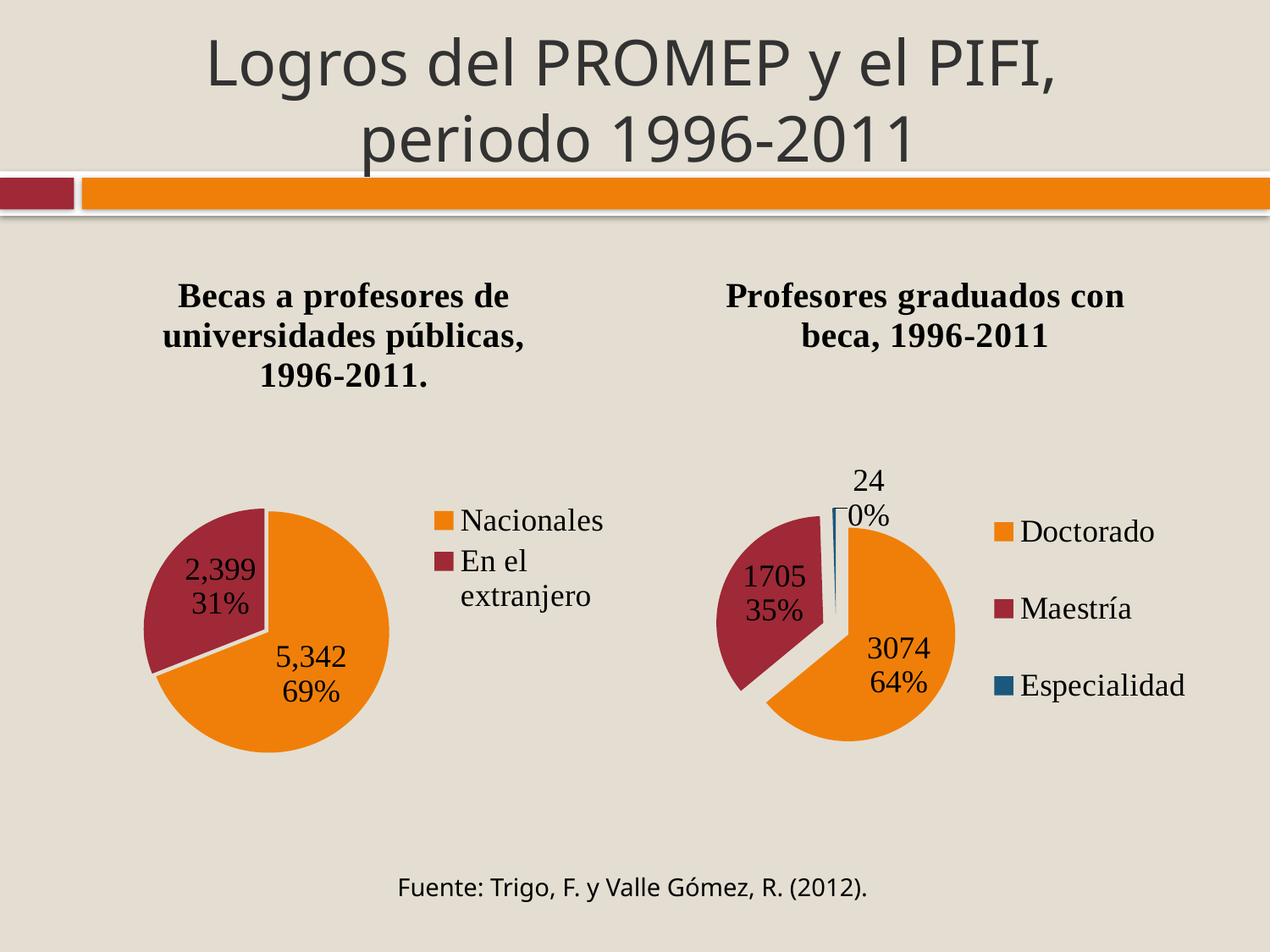
In the 'Becas a profesores de universidades públicas, 1996-2011' chart, what is the difference between Nacionales and En el extranjero? 2,943 In the 'Profesores graduados con beca, 1996-2011' chart, what share of the pie is Doctorado? 64% In the 'Becas a profesores de universidades públicas, 1996-2011' chart, what is the value for Nacionales? 5,342 In the 'Profesores graduados con beca, 1996-2011' chart, which category is the smallest? Especialidad In the 'Profesores graduados con beca, 1996-2011' chart, what is the value for Maestría? 1705 In the 'Profesores graduados con beca, 1996-2011' chart, which is larger, Doctorado or Maestría? Doctorado In the 'Profesores graduados con beca, 1996-2011' chart, what is the value for Especialidad? 24 How many categories does the legend of the 'Profesores graduados con beca, 1996-2011' chart list? 3 In the 'Becas a profesores de universidades públicas, 1996-2011' chart, which category is the largest? Nacionales In the 'Becas a profesores de universidades públicas, 1996-2011' chart, what share of the pie is Nacionales? 69% What kind of chart is the 'Becas a profesores de universidades públicas, 1996-2011' chart? Pie chart In the 'Becas a profesores de universidades públicas, 1996-2011' chart, what is the value for En el extranjero? 2,399